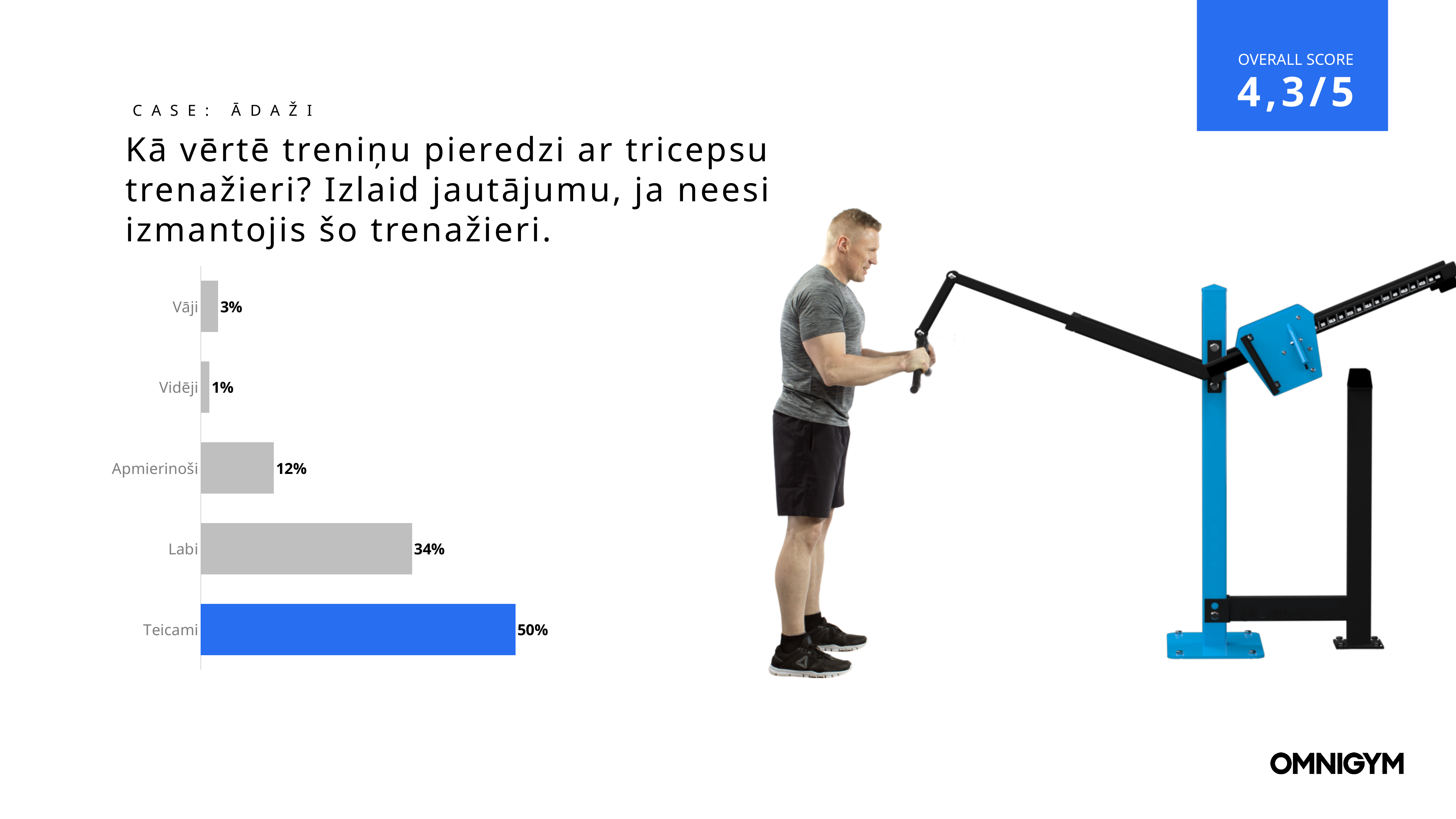
What kind of chart is shown on the slide? Bar chart What is the value shown for "Labi"? 34% What is the difference between the values for "Teicami" and "Labi"? 16% What percentage of respondents rated the triceps trainer experience as "Teicami"? 50% Which bar in the chart is coloured blue rather than grey? Teicami Which is larger, the value for "Apmierinoši" or the value for "Vāji"? Apmierinoši Which category has the lowest value? Vidēji What is the value shown for "Apmierinoši"? 12% What overall score is shown in the box at the top right of the slide? 4,3/5 Which category has the highest value? Teicami How many categories are shown in the bar chart? 5 What is the value shown for "Vāji"? 3%